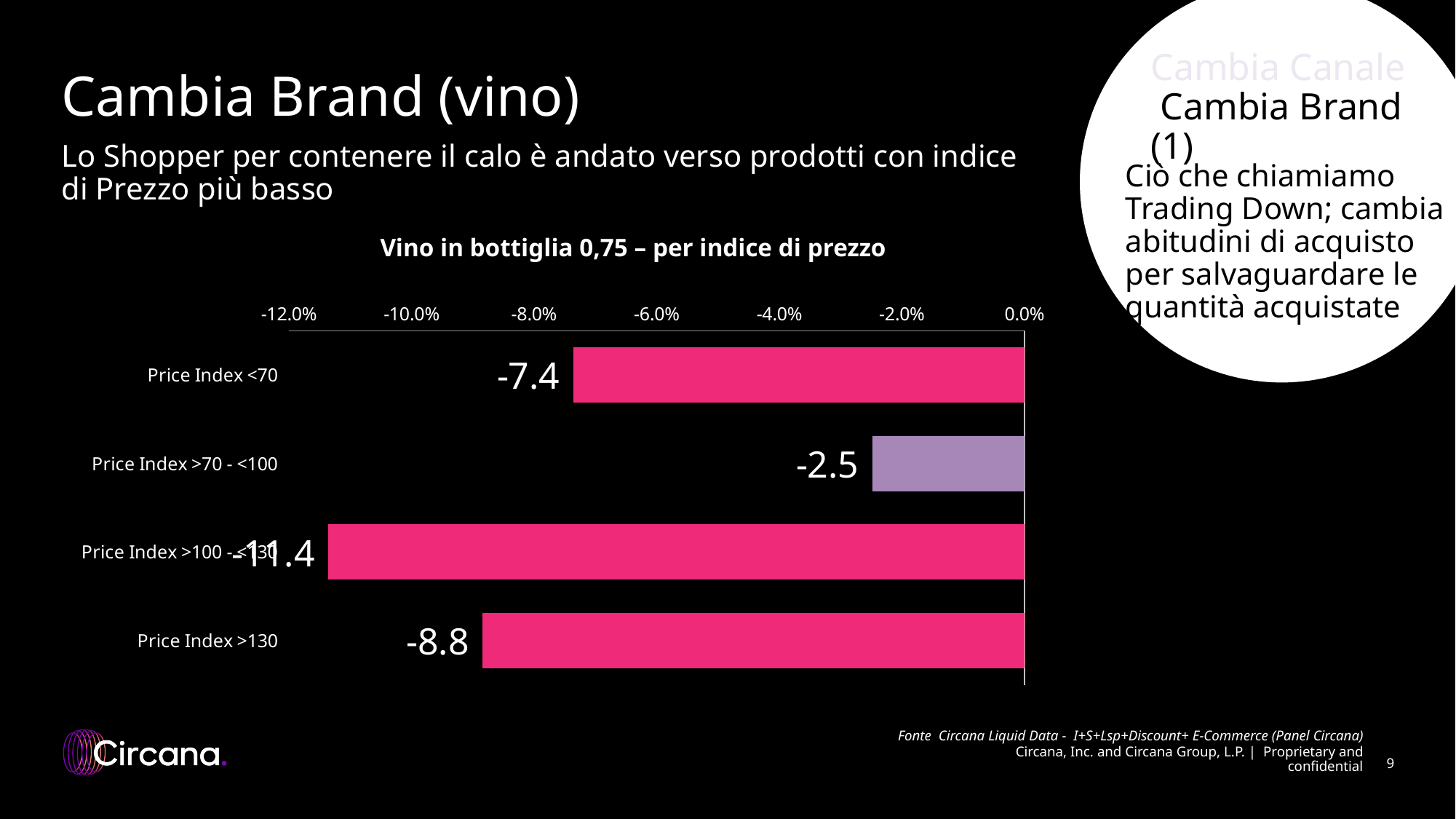
What is the value shown on the third bar from the top? -11.4 What is the difference between the values for Price Index >130 and Price Index <70? 1.4 Which bar shows the lowest (most negative) value? the third bar from the top (-11.4) Which has a more negative value, Price Index <70 or Price Index >70 - <100? Price Index <70 What is the value for Price Index <70? -7.4 Which bar is shown in a different colour (purple) from the others? Price Index >70 - <100 What type of chart is shown on the slide? bar chart What is the value for Price Index >70 - <100? -2.5 How many categories are plotted in the chart? 4 Which category has the highest (least negative) value? Price Index >70 - <100 What is the value for Price Index >130? -8.8 What is the title of the chart? Vino in bottiglia 0,75 – per indice di prezzo